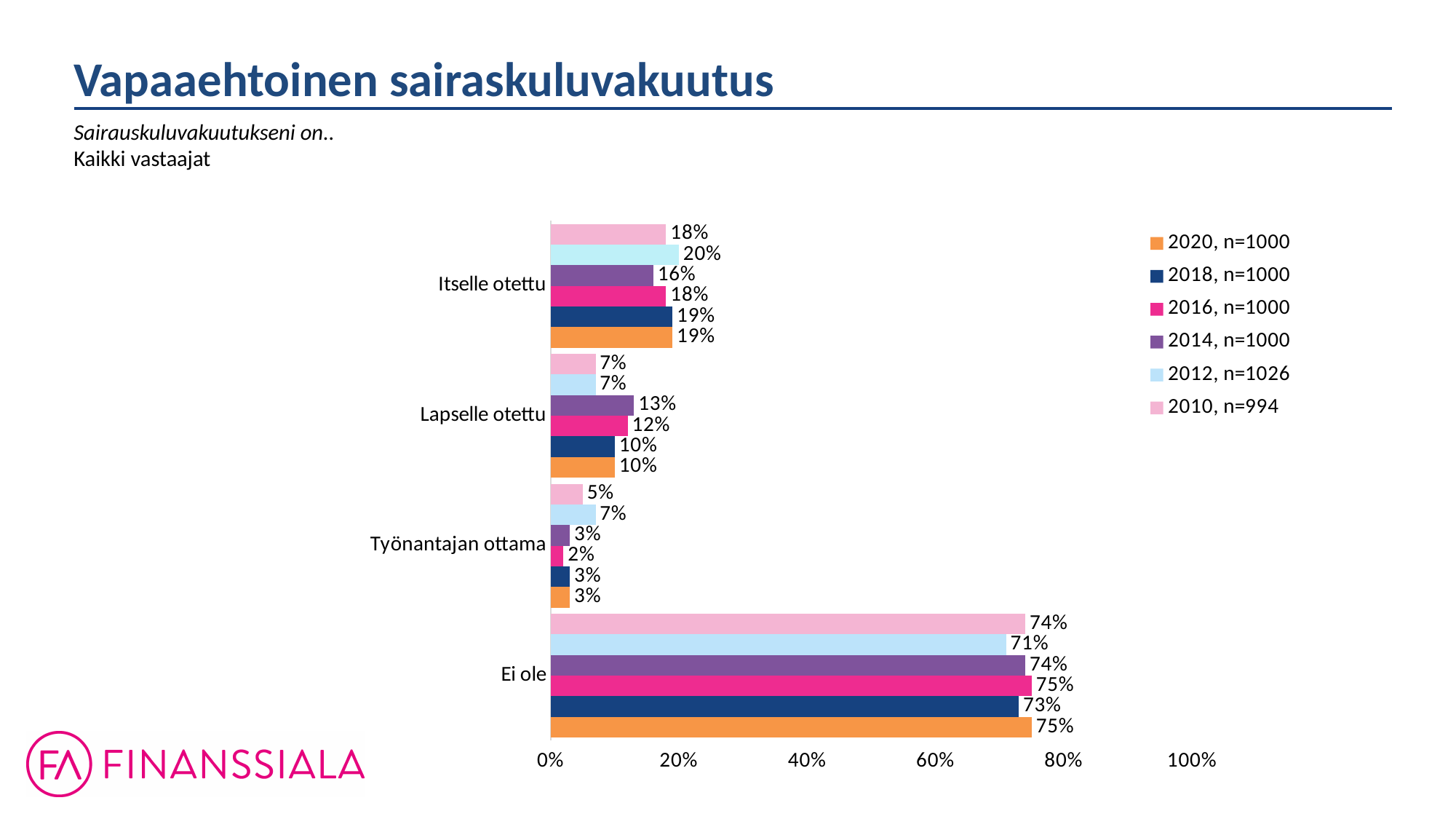
Which category has the highest value in the 2018, n=1000 series? Ei ole What is the value for "Lapselle otettu" in the 2014, n=1000 series? 13% What is the value for "Itselle otettu" in the 2012, n=1026 series? 20% What is the value for "Ei ole" in the 2020, n=1000 series? 75% What is the sample size (n) given in the legend for the 2012 series? 1026 How many categories are shown on the y axis? 4 What kind of chart is shown on the slide? Bar chart Which category has the lowest value in the 2010, n=994 series? Työnantajan ottama Which is larger for "Lapselle otettu": the 2014 value or the 2020 value? 2014 How many series does the legend list? 6 What is the difference between the 2020 and 2018 values for "Ei ole"? 2% What is the value for "Työnantajan ottama" in the 2016, n=1000 series? 2%